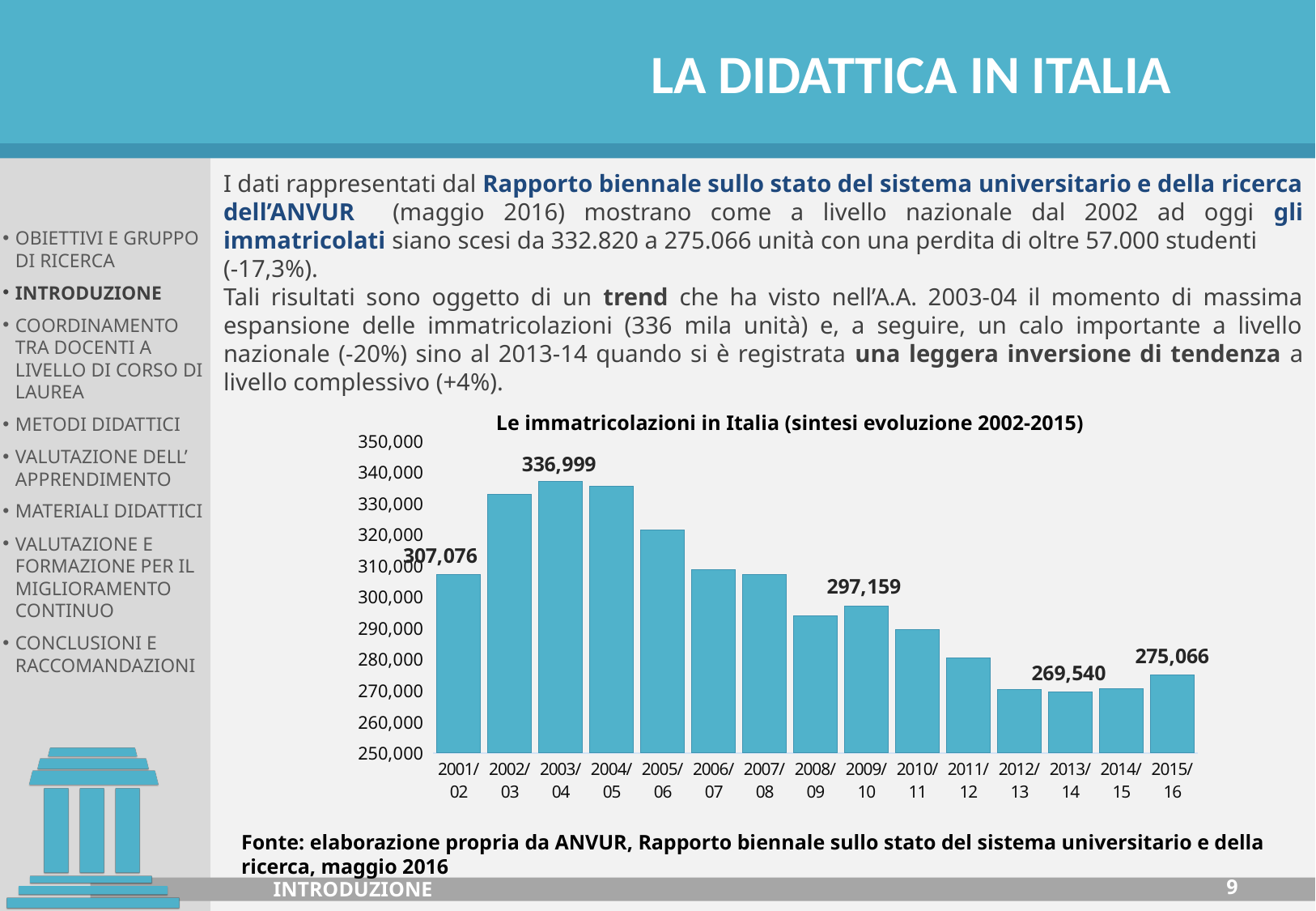
What is the value for 2001/02 in the chart? 307,076 What is the value for 2003/04 in the chart? 336,999 What is the value for 2009/10 in the chart? 297,159 What is the value for 2015/16 in the chart? 275,066 Is the value for 2010/11 greater or less than 300,000? less Which is larger, the value for 2009/10 or the value for 2015/16? 2009/10 What kind of chart is shown on the slide? bar chart Which academic year has the highest number of immatricolazioni in the chart? 2003/04 How many academic years are shown on the x axis of the chart? 15 What is the difference between the values for 2003/04 and 2015/16? 61,933